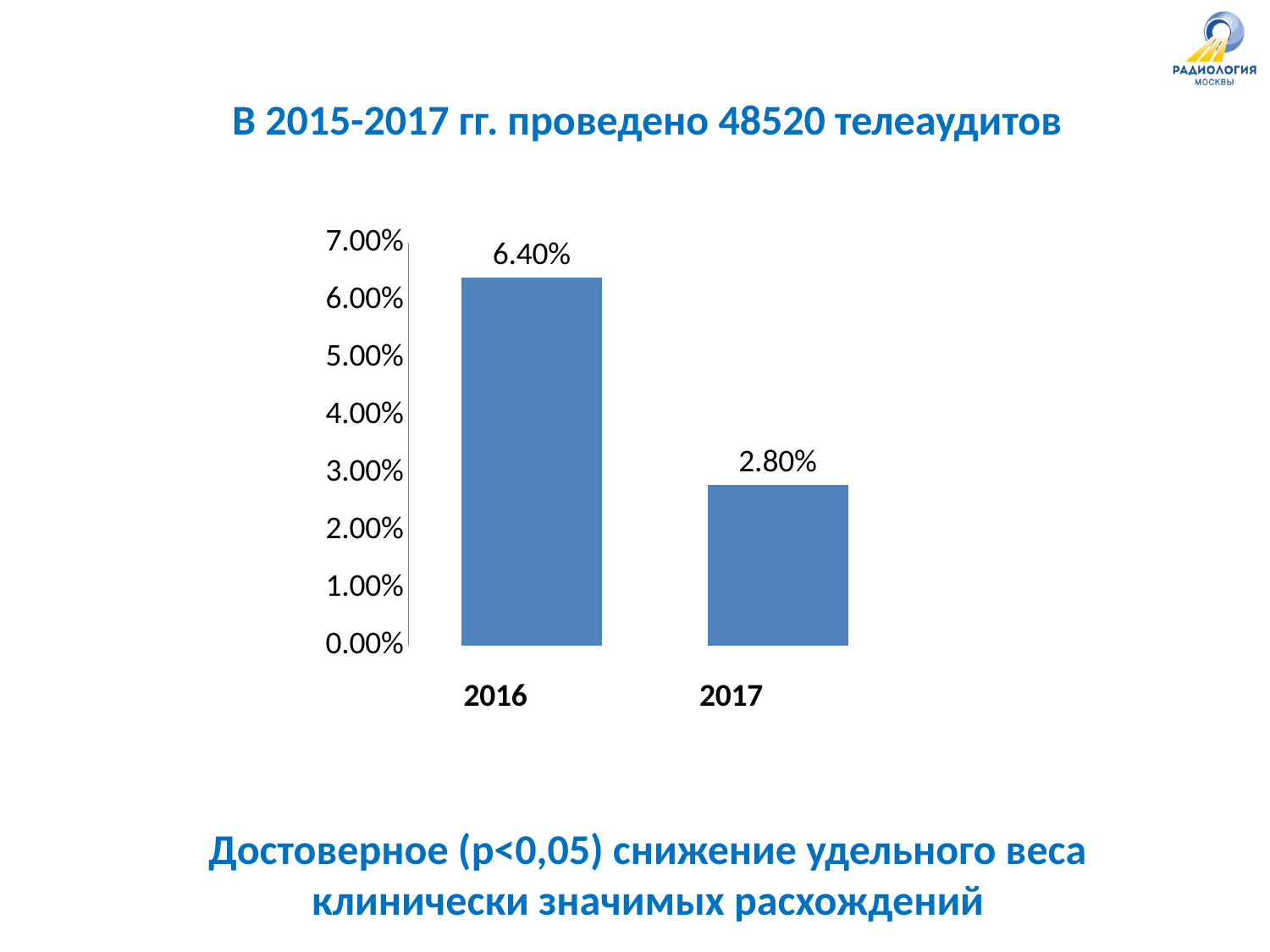
Is the value for 2016 greater or less than 6.00%? greater Which year has the highest value? 2016 Is the value for 2017 greater or less than 3.00%? less Which year has the lowest value? 2017 Which is larger, the value for 2016 or the value for 2017? 2016 How many categories are shown on the x axis? 2 What is the value for 2016? 6.40% What is the difference between the values for 2016 and 2017? 3.60% What kind of chart is shown on the slide? bar chart Do the values rise or fall from 2016 to 2017? fall What is the highest value shown on the y axis? 7.00% What is the value for 2017? 2.80%